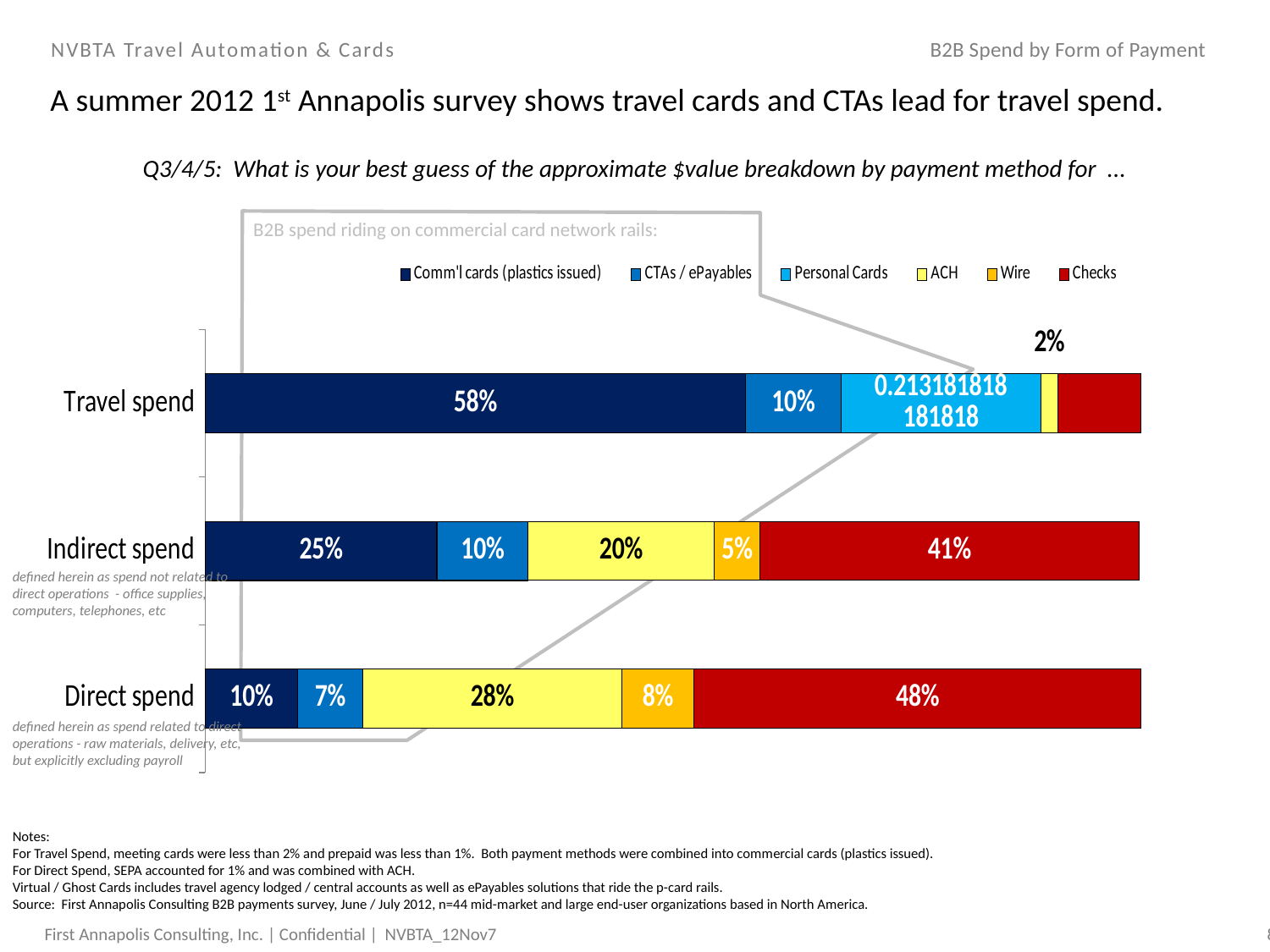
What share of Direct spend is paid by Wire? 8% By how many percentage points does the Checks share of Direct spend exceed the Checks share of Indirect spend? 7 percentage points How many series does the chart legend list? 6 What share of Travel spend is on Comm'l cards (plastics issued)? 58% How many spend categories are plotted on the chart? 3 What share of Direct spend is paid by Checks? 48% Which has a larger Comm'l cards (plastics issued) share, Indirect spend or Direct spend? Indirect spend What share of Travel spend is on CTAs / ePayables? 10% What share of Indirect spend is paid by ACH? 20% Which spend category has the largest share paid by Checks? Direct spend What is the first entry in the chart legend? Comm'l cards (plastics issued) What kind of chart is shown on the slide? Stacked bar chart